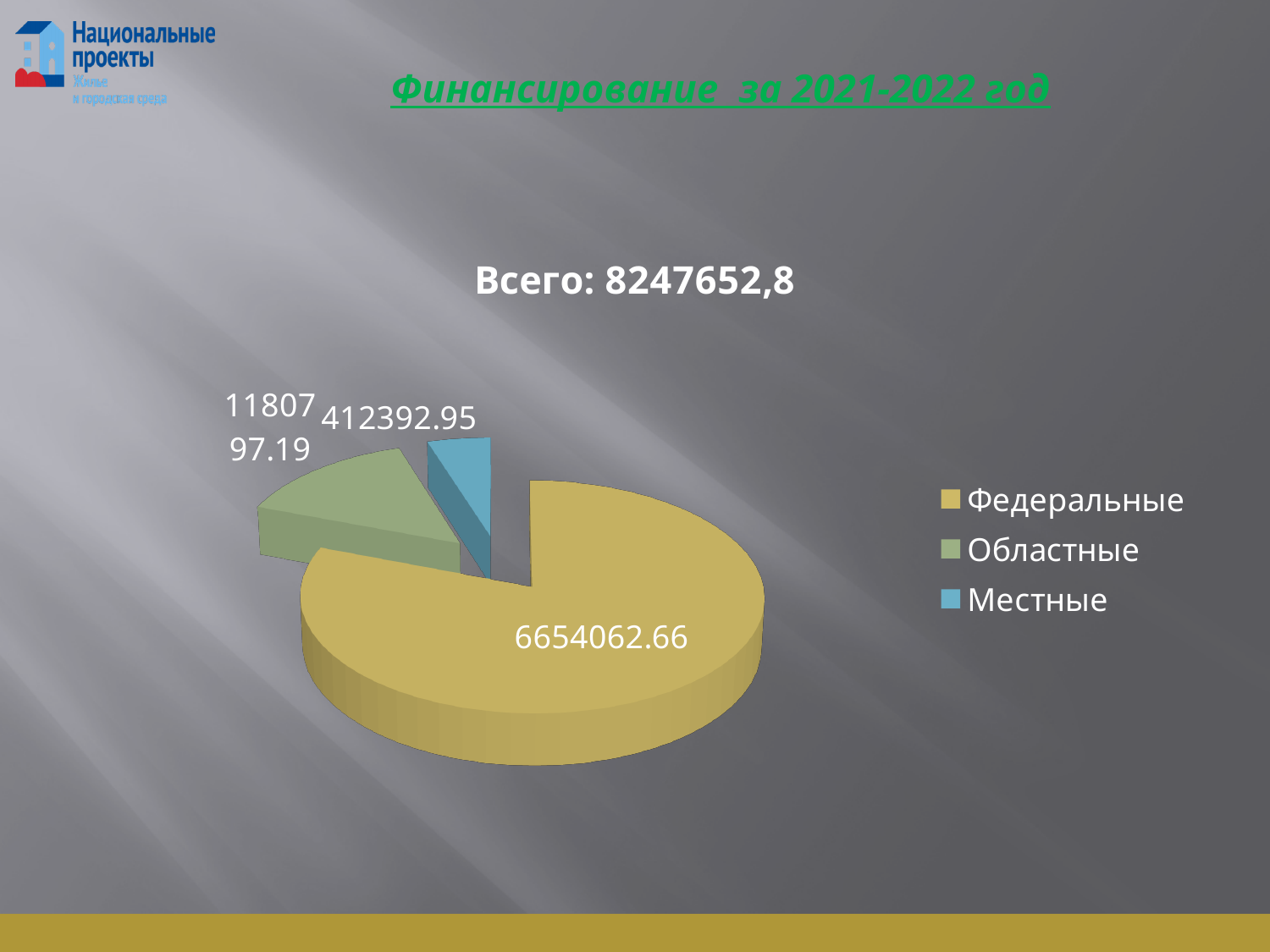
What total (Всего) is printed above the pie chart? 8247652,8 Which is larger, the value for Областные or the value for Местные? Областные What is the difference between the values for Федеральные and Местные? 6241669.71 What is the difference between the values for Областные and Местные? 768404.24 How many slices does the pie chart have? 3 What is the value shown for Местные? 412392.95 Which category has the largest slice of the pie? Федеральные What is the title of the slide above the chart? Финансирование за 2021-2022 год What is the value shown for Областные? 1180797.19 What kind of chart is shown on the slide? pie chart What is the value shown for Федеральные? 6654062.66 Which category has the smallest slice of the pie? Местные